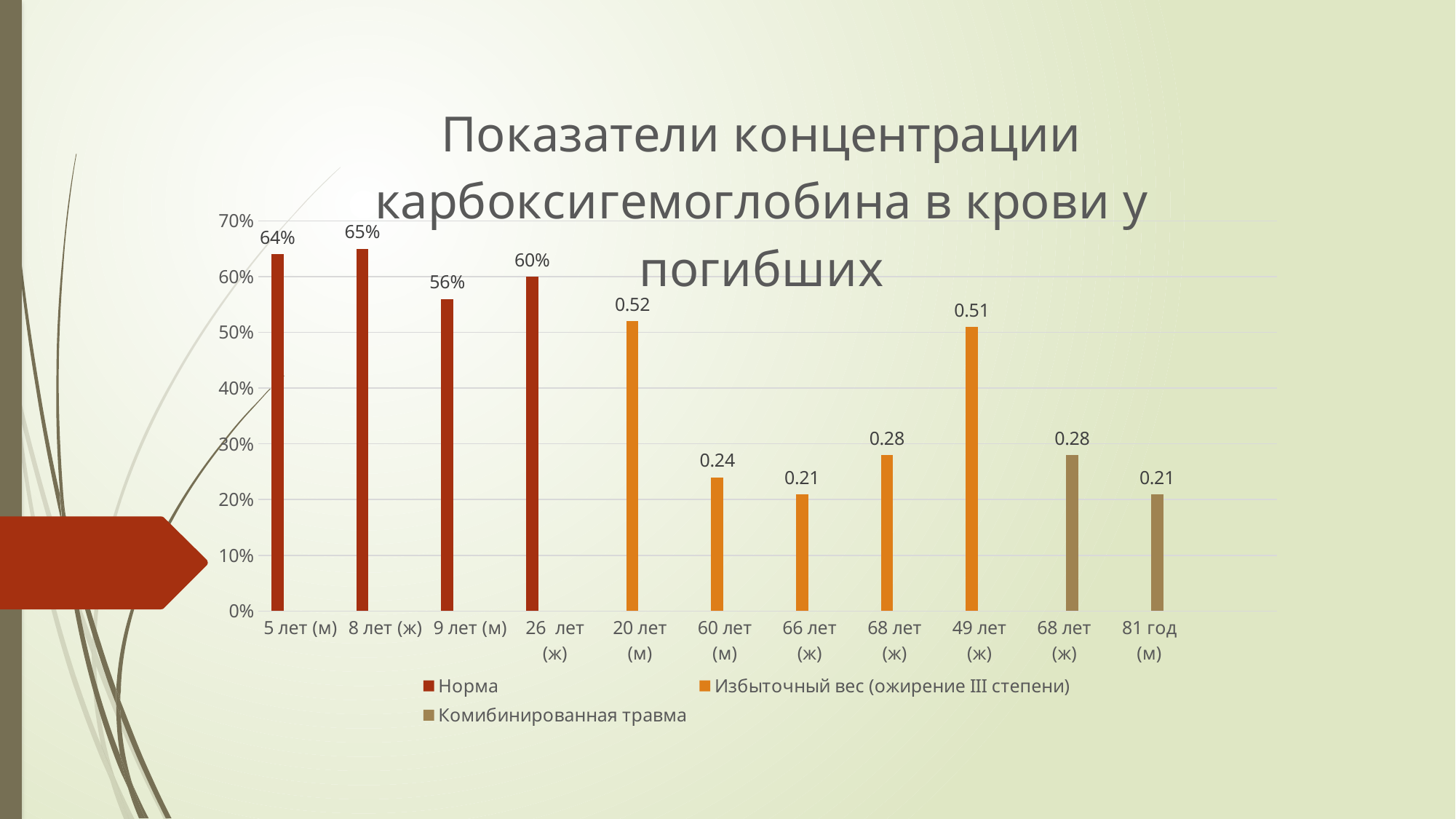
What is the difference between the values for 8 лет (ж) and 9 лет (м)? 9% What is the value for 20 лет (м)? 0.52 What type of chart is shown on the slide? bar chart How many categories are shown on the x axis? 11 What is the value for 81 год (м)? 0.21 Which is larger, the value for 60 лет (м) or the value for 66 лет (ж)? 60 лет (м) What is the value for 5 лет (м)? 64% What is the value for 49 лет (ж)? 0.51 Is the value for 26 лет (ж) greater or less than 50%? greater Which series is shown in dark red? Норма How many series does the legend list? 3 Which category has the highest value? 8 лет (ж)